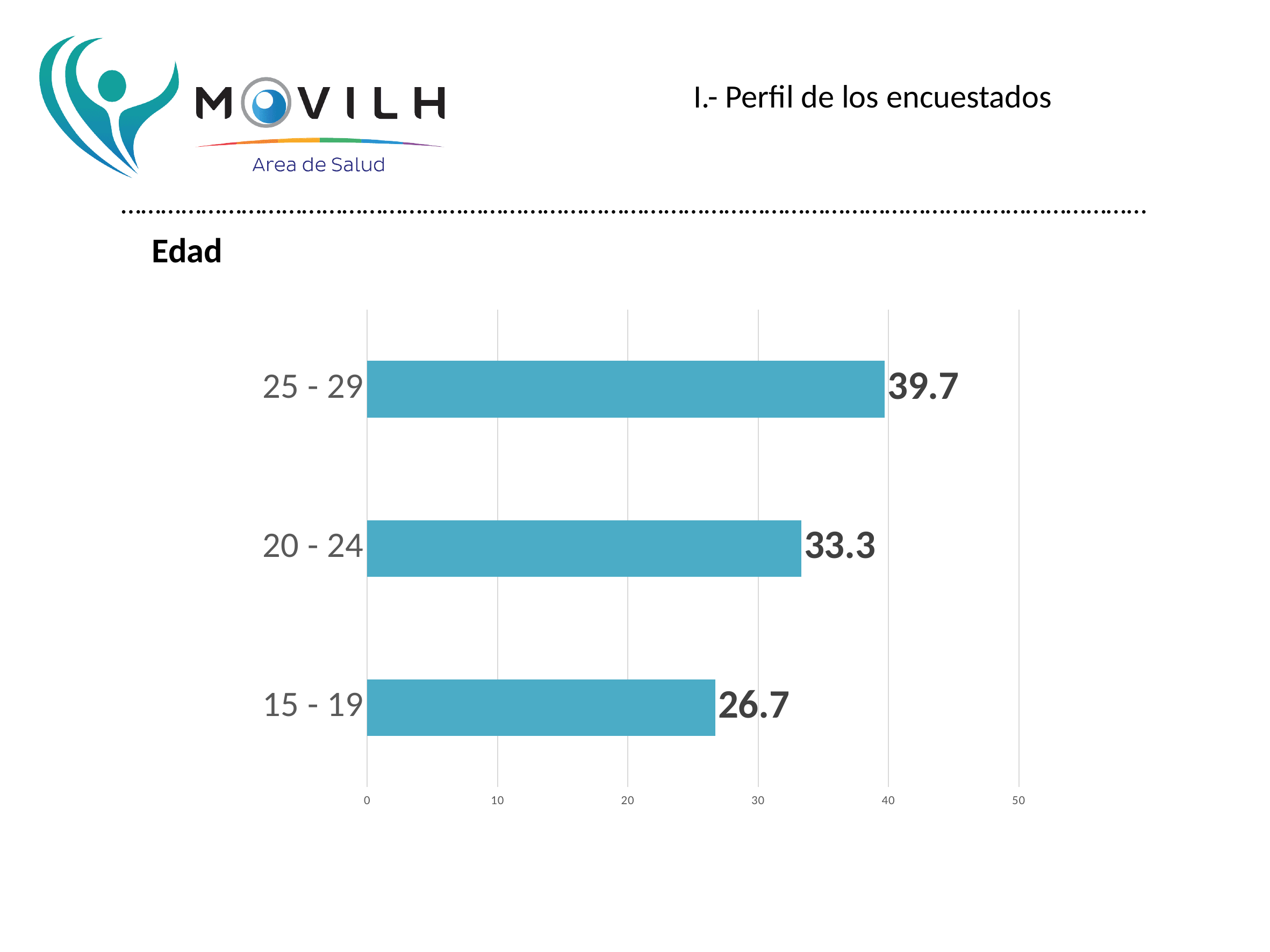
Which is larger, the value for 20 - 24 or the value for 15 - 19? 20 - 24 Which age group has the highest value? 25 - 29 What is the value for the 20 - 24 age group? 33.3 What is the value for the 15 - 19 age group? 26.7 Which age group has the lowest value? 15 - 19 What is the title of the chart? Edad Is the value for 20 - 24 greater or less than 30? greater What is the difference between the values for 25 - 29 and 20 - 24? 6.4 What is the difference between the values for 25 - 29 and 15 - 19? 13.0 What kind of chart is shown on the slide? Bar chart How many age groups are shown in the chart? 3 What is the value for the 25 - 29 age group? 39.7